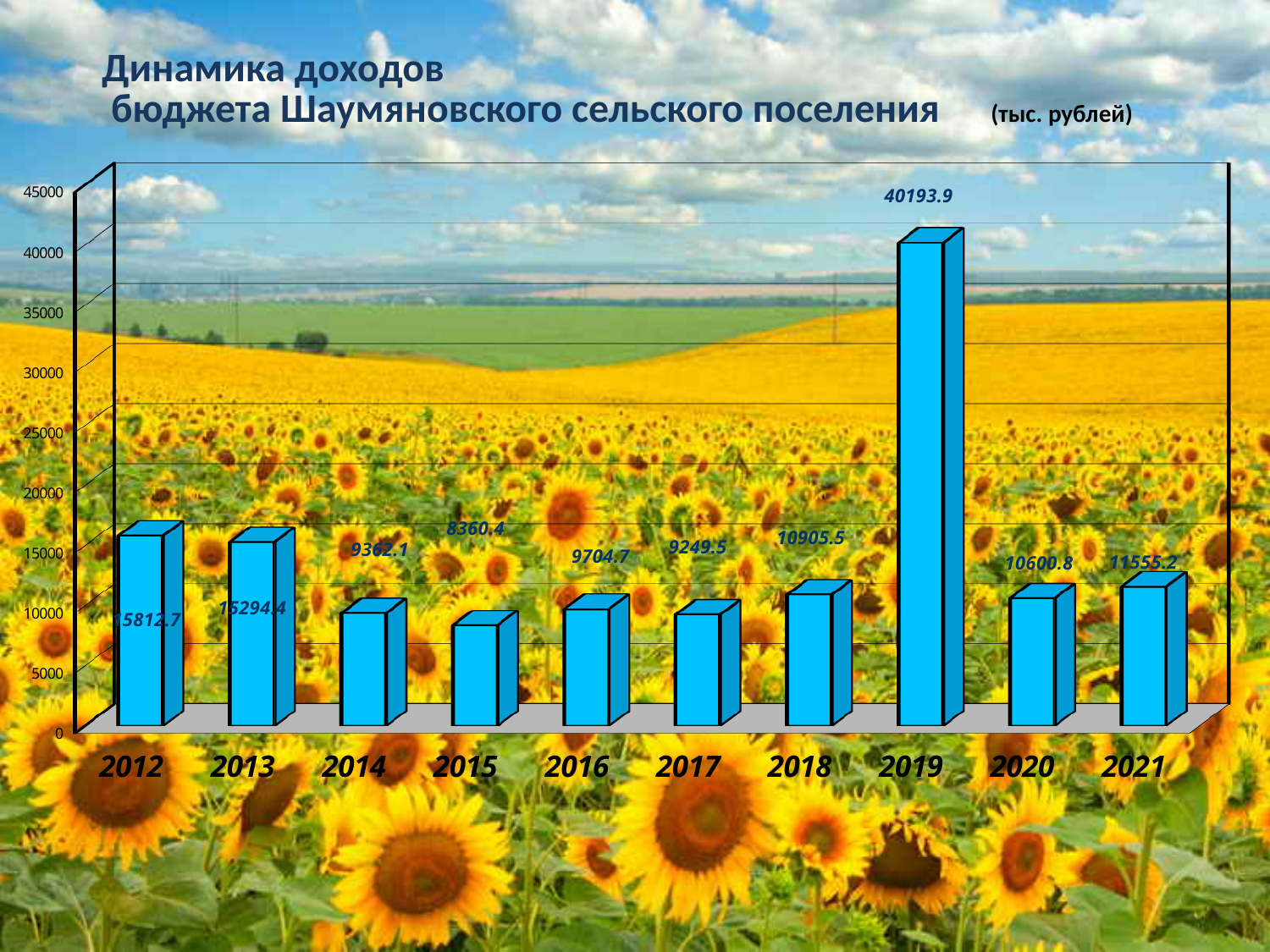
Which year has the lowest budget revenue in the chart? 2015 Which year has the larger value, 2016 or 2017? 2016 What kind of chart is shown on the slide? bar chart By how much does the value for 2021 exceed the value for 2020? 954.4 How many years are shown on the x axis of the chart? 10 Which year has the highest budget revenue in the chart? 2019 Is the value for 2012 greater or less than 10000? greater What is the budget revenue value shown for 2015? 8360.4 What is the budget revenue value shown for 2018? 10905.5 What is the budget revenue value shown for 2021? 11555.2 What is the budget revenue value shown for 2019? 40193.9 In what units are the values in the chart expressed, according to the slide? тыс. рублей